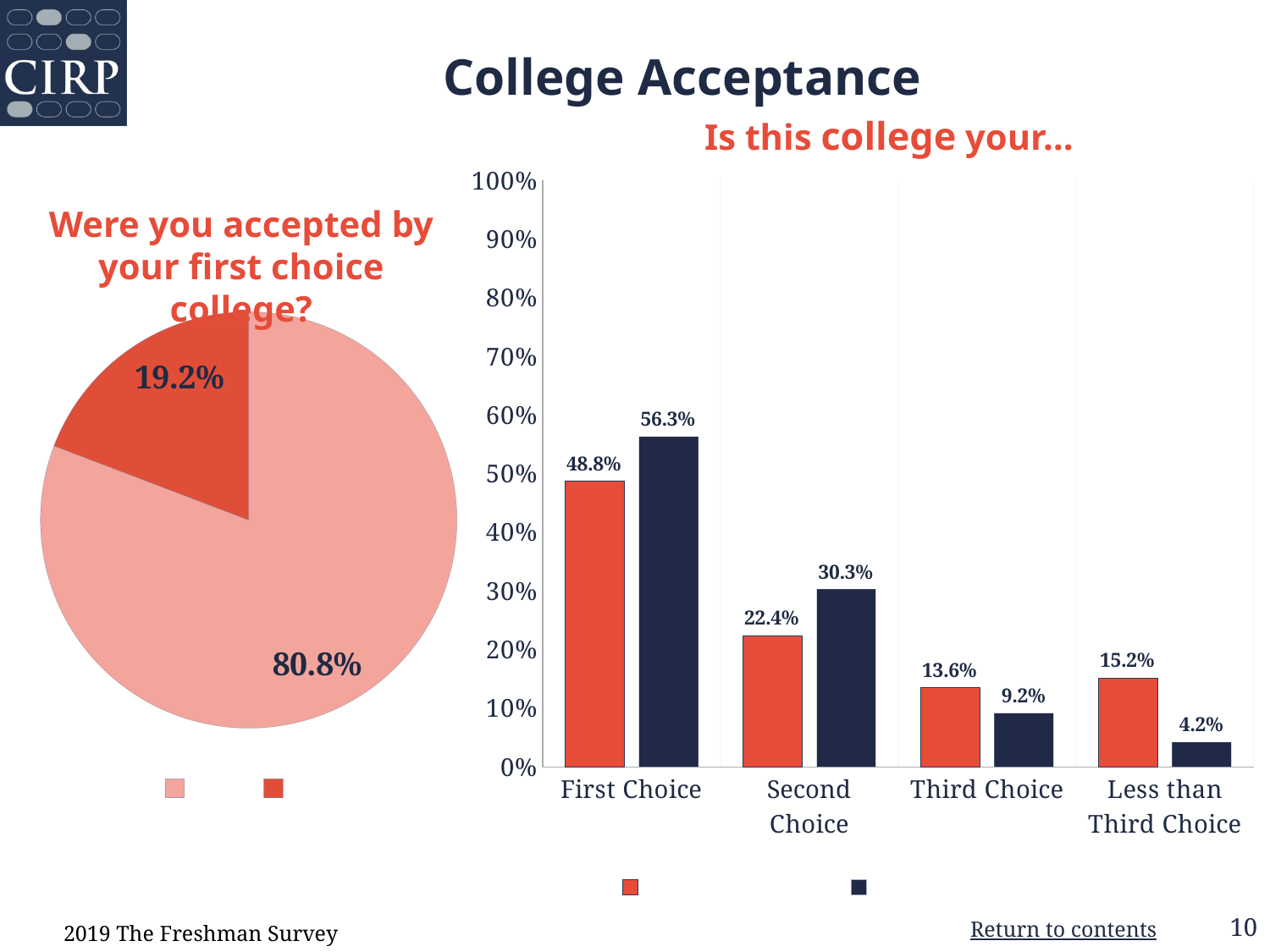
In the bar chart titled "Is this college your...", do the red bars generally rise or fall from First Choice to Third Choice? fall In the bar chart titled "Is this college your...", what is the difference between the dark navy bar and the red bar for First Choice? 7.5% In the bar chart titled "Is this college your...", which is larger for Third Choice: the red bar or the dark navy bar? the red bar In the bar chart titled "Is this college your...", which category has the lowest red bar? Third Choice In the bar chart titled "Is this college your...", which category has the highest dark navy bar? First Choice In the bar chart titled "Is this college your...", what is the value of the dark navy bar for Second Choice? 30.3% In the pie chart titled "Were you accepted by your first choice college?", what share does the larger slice represent? 80.8% In the bar chart titled "Is this college your...", what is the value of the dark navy bar for Less than Third Choice? 4.2% What kind of chart is the chart on the left of the slide? pie chart In the bar chart titled "Is this college your...", what is the value of the red bar for First Choice? 48.8% In the bar chart titled "Is this college your...", how many categories are shown on the x axis? 4 In the bar chart titled "Is this college your...", how many series does the legend list? 2